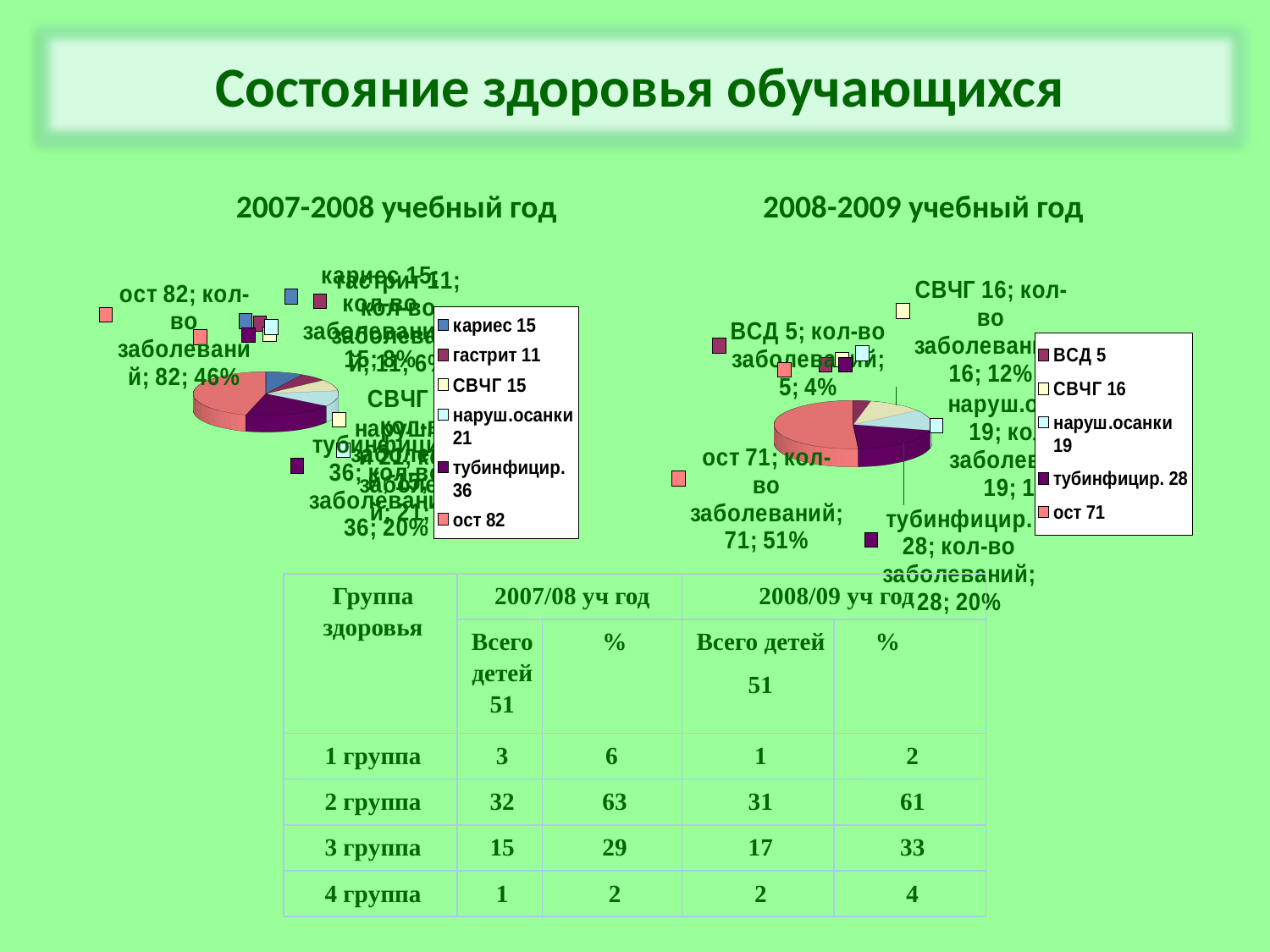
In the 2007-2008 учебный год pie chart, what value is shown for тубинфицир.? 36 In the 2008-2009 учебный год pie chart, what value is shown for ВСД? 5 In the 2008-2009 учебный год pie chart, which category has the smallest slice? ВСД In the 2007-2008 учебный год pie chart, what share of the pie does ост represent? 46% Which is larger: СВЧГ in the 2007-2008 pie chart or СВЧГ in the 2008-2009 pie chart? 2008-2009 (16) In the 2008-2009 учебный год pie chart, what share of the pie does тубинфицир. represent? 20% In the 2007-2008 учебный год pie chart, which category has the largest slice? ост How many categories does the legend of the 2007-2008 учебный год pie chart list? 6 In the 2007-2008 учебный год pie chart, what value is shown for ост? 82 In the 2008-2009 учебный год pie chart, what value is shown for наруш.осанки? 19 What type of chart is used for the 2008-2009 учебный год data? Pie chart What is the difference between the ост values in the 2007-2008 and 2008-2009 pie charts? 11